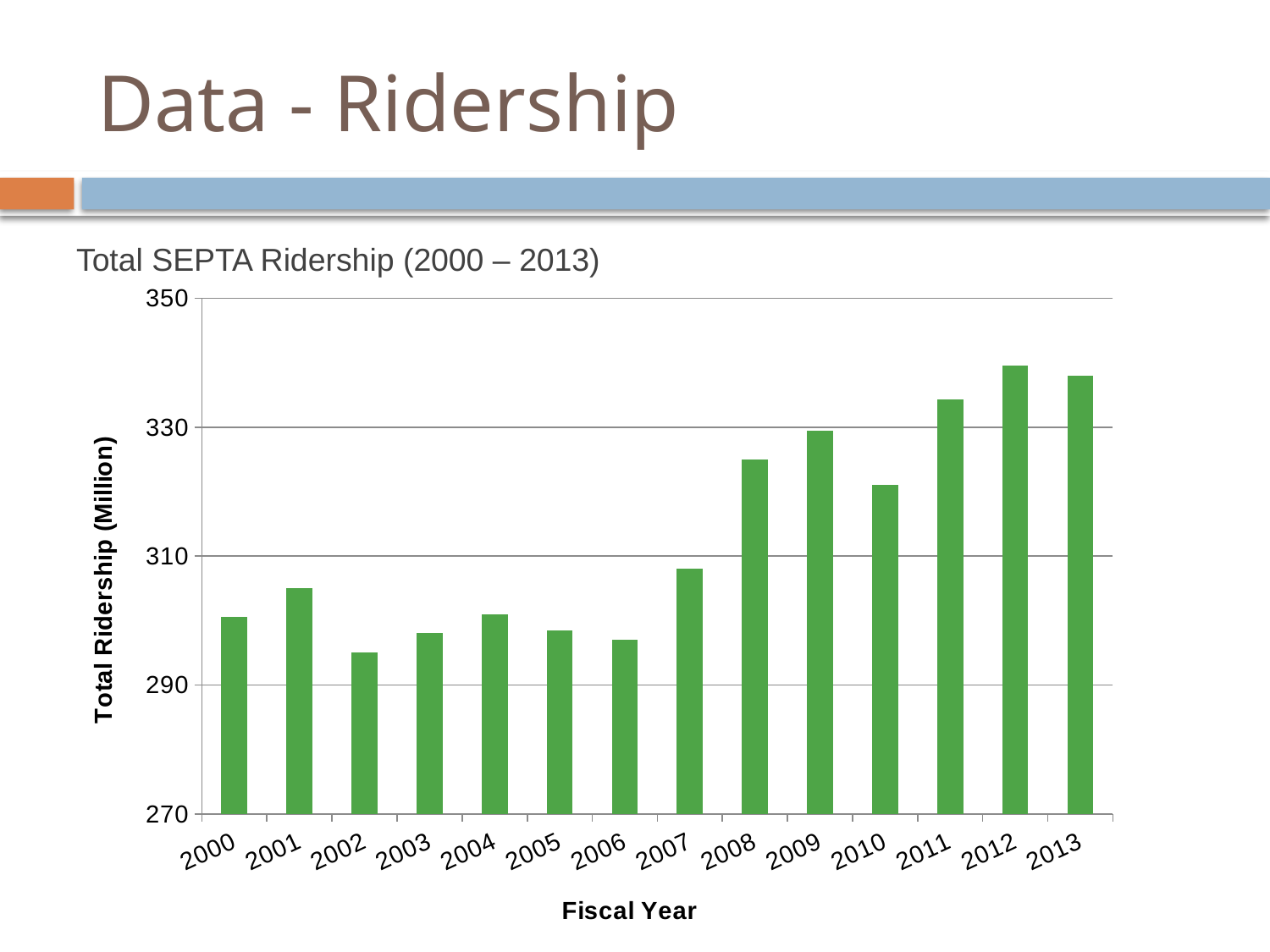
Is the total ridership for 2008 greater or less than 310? greater Which fiscal year had higher total ridership, 2009 or 2010? 2009 Is the total ridership for 2011 greater or less than 330? greater Which fiscal year has the lowest total ridership? 2002 Which fiscal year has the highest total ridership? 2012 What is the label on the vertical axis of the chart? Total Ridership (Million) What kind of chart is shown on the slide? Bar chart Overall, does total ridership rise or fall from 2000 to 2013? Rise Is the total ridership for 2002 greater or less than 290? greater How many fiscal years are plotted in the Total SEPTA Ridership chart? 14 Which fiscal year had higher total ridership, 2000 or 2001? 2001